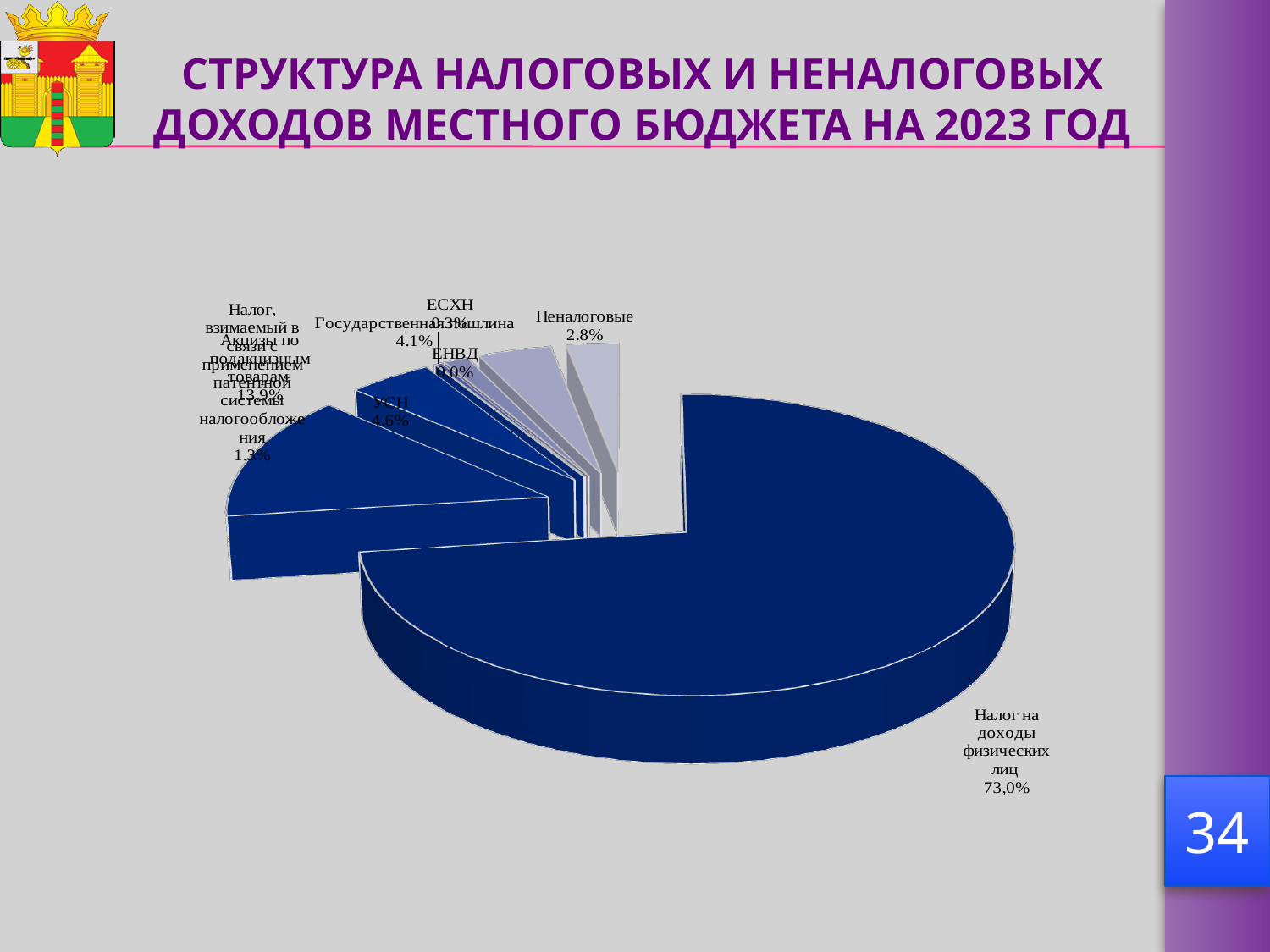
What share is shown for Государственная пошлина? 4.1% How many slices does the pie chart have? 8 What share is shown for ЕНВД? 0.0% What is the difference in percentage points between Налог на доходы физических лиц and Неналоговые? 70,2 What share is shown for УСН? 4.6% Which category has the largest share of the pie? Налог на доходы физических лиц What share is shown for Неналоговые? 2.8% What kind of chart is shown on the slide? pie chart Which category has the smallest share of the pie? ЕНВД What share of the pie is labelled for Налог на доходы физических лиц? 73,0% Which is larger, the share for УСН or the share for Государственная пошлина? УСН What share is shown for Акцизы по подакцизным товарам? 13.9%